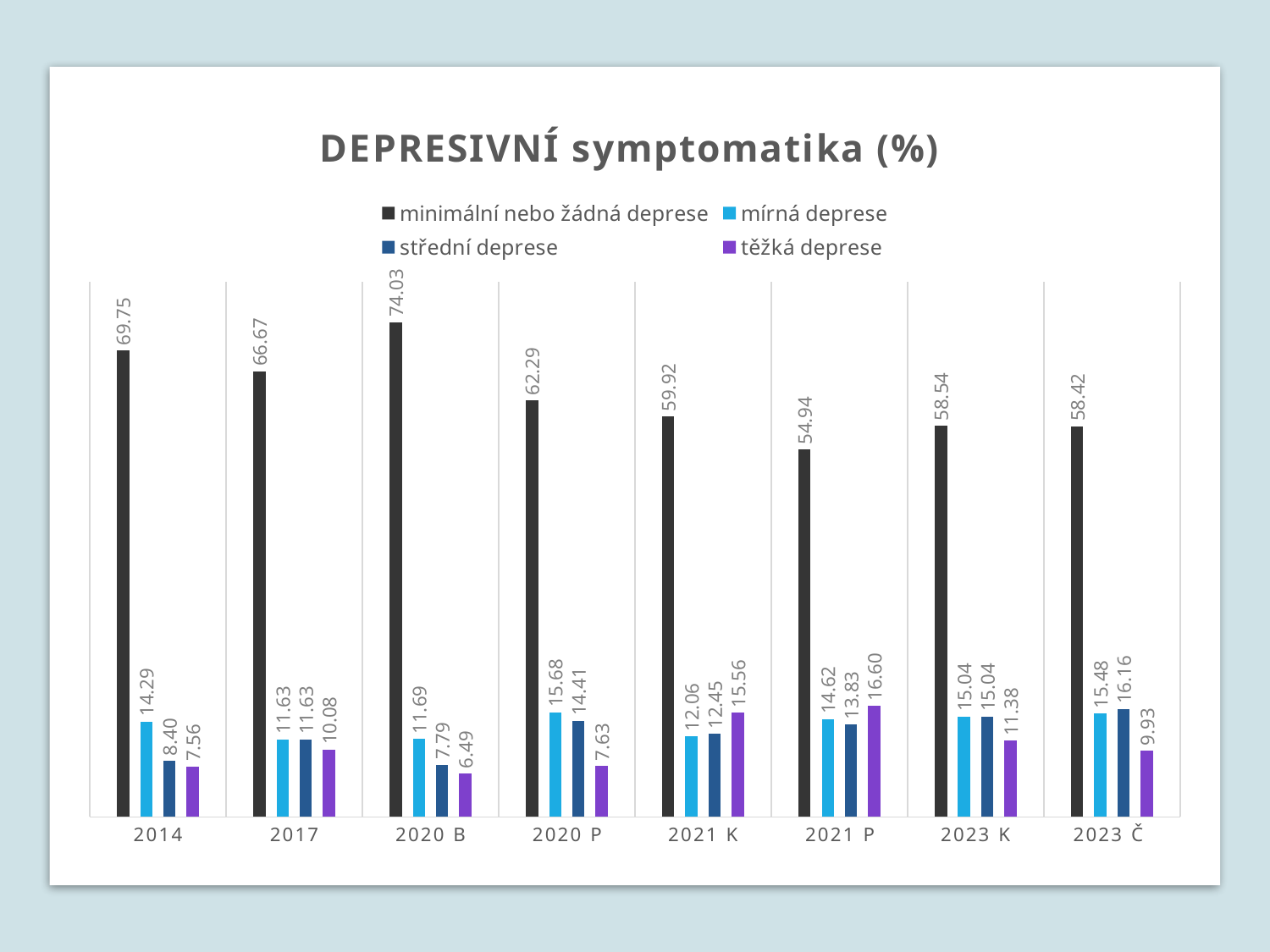
What is the value for 'minimální nebo žádná deprese' in 2014? 69.75 How many series does the legend list? 4 Do the values for 'minimální nebo žádná deprese' rise or fall from 2020 B to 2023 Č? fall What is the title of the chart? DEPRESIVNÍ symptomatika (%) What is the value for 'mírná deprese' in 2020 P? 15.68 Which category has the lowest value for 'těžká deprese'? 2020 B How many categories are shown on the x axis? 8 What is the difference between the 'minimální nebo žádná deprese' values for 2020 B and 2023 Č? 15.61 Which category has the highest value for 'minimální nebo žádná deprese'? 2020 B What kind of chart is shown on the slide? bar chart Which is larger: 'střední deprese' in 2023 Č or 'střední deprese' in 2014? 2023 Č What is the value for 'těžká deprese' in 2021 P? 16.60